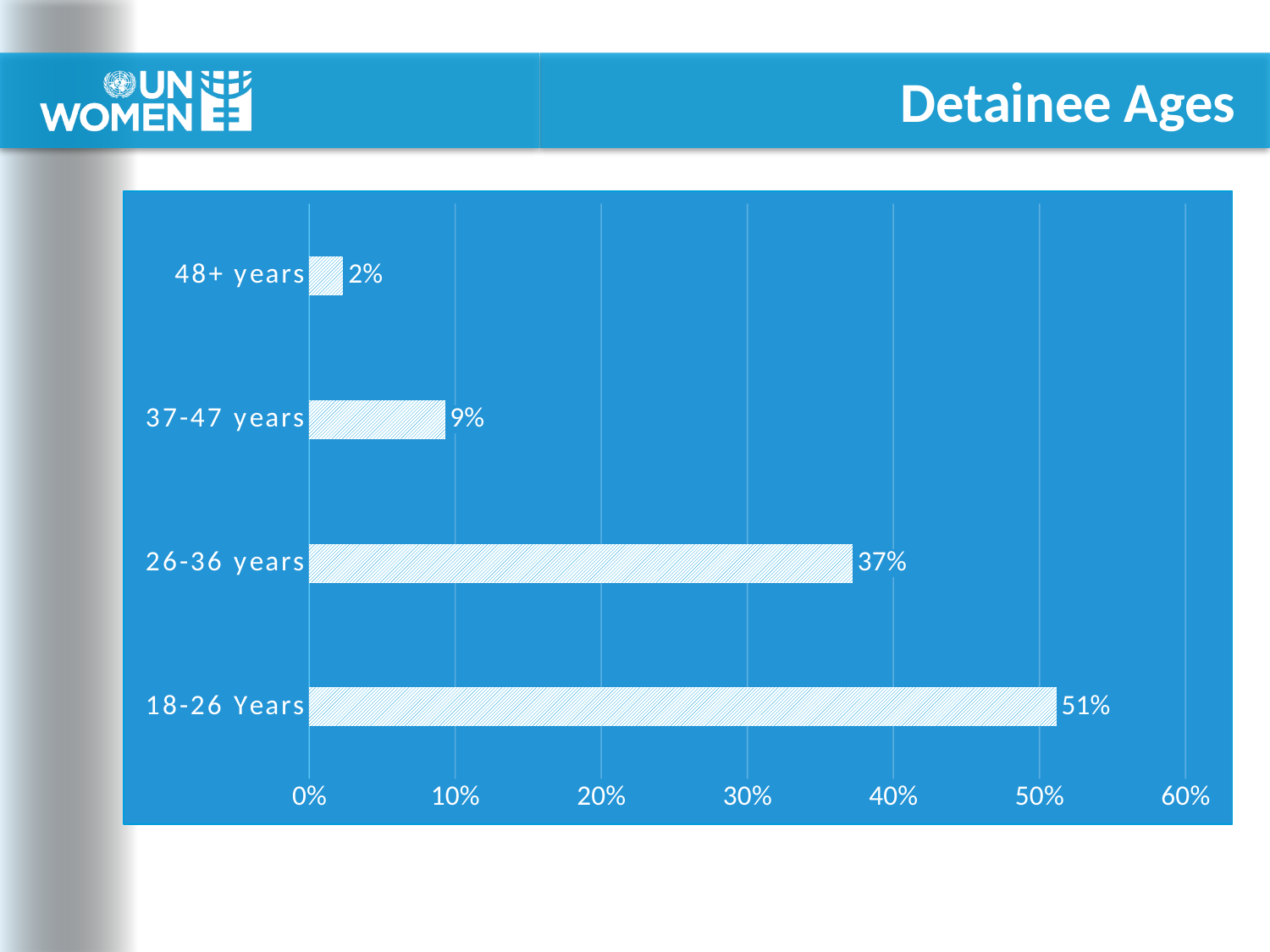
What is the value for the 37-47 years category? 9% What is the value for the 18-26 Years category? 51% Which age group has the lowest value? 48+ years Which is larger, the value for 26-36 years or the value for 37-47 years? 26-36 years How many age categories are shown in the chart? 4 Which age group has the highest value? 18-26 Years What is the value for the 26-36 years category? 37% What is the difference between the values for 18-26 Years and 26-36 years? 14% What is the difference between the values for 37-47 years and 48+ years? 7% What is the value for the 48+ years category? 2% What kind of chart is shown on the slide? Bar chart Is the value for 18-26 Years greater or less than 50%? greater